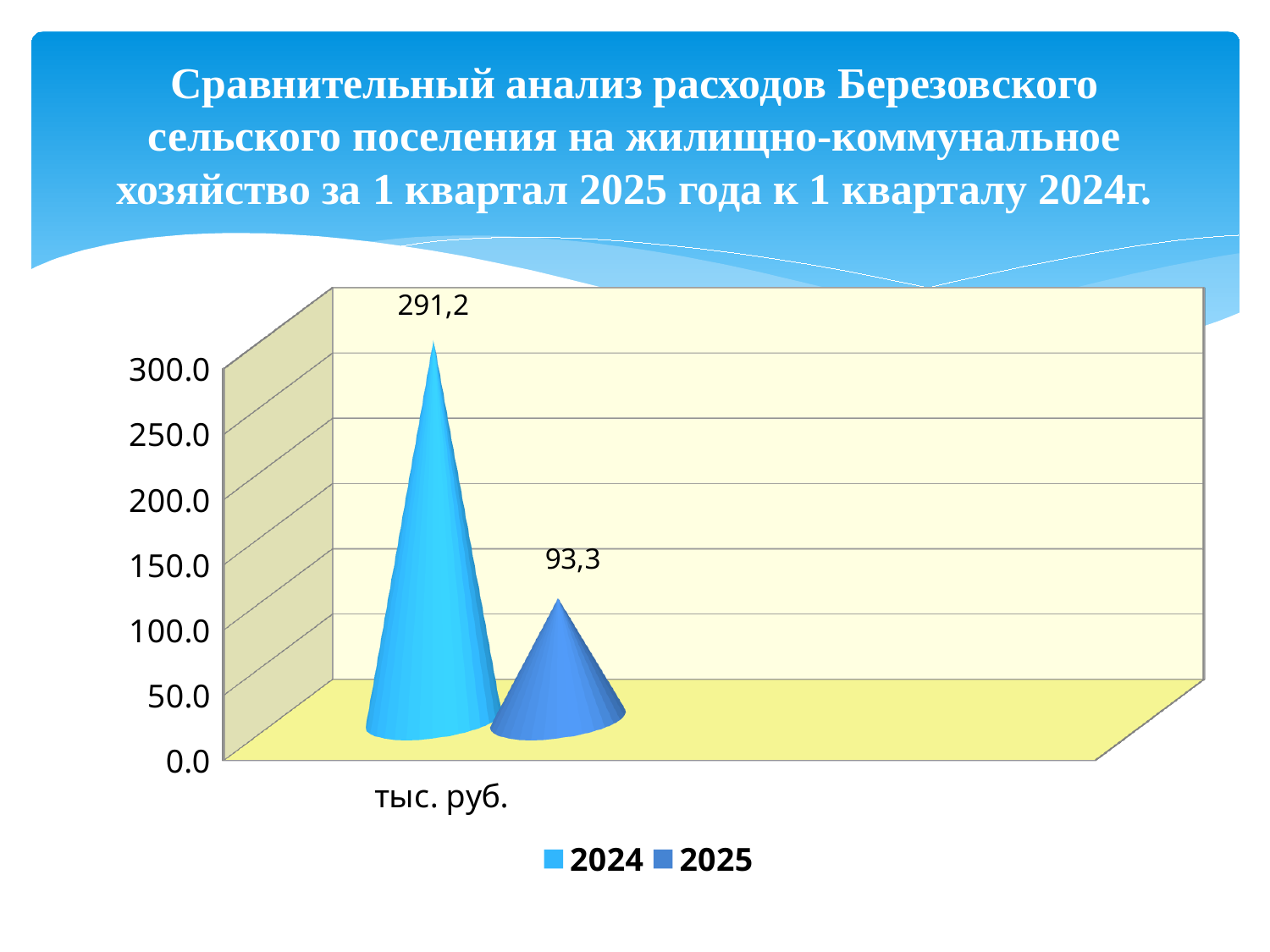
Is the value for 2025 greater or less than 100.0? less Which series has the highest value? 2024 Which series has the lowest value? 2025 What is the highest value shown on the vertical axis? 300.0 What is the value for 2024? 291,2 Which series has the higher value, 2024 or 2025? 2024 What is the category label shown on the x axis? тыс. руб. What is the value for 2025? 93,3 Is the value for 2024 greater or less than 250.0? greater What is the difference between the 2024 value and the 2025 value? 197,9 What kind of chart is shown on the slide? bar chart How many series does the legend list? 2